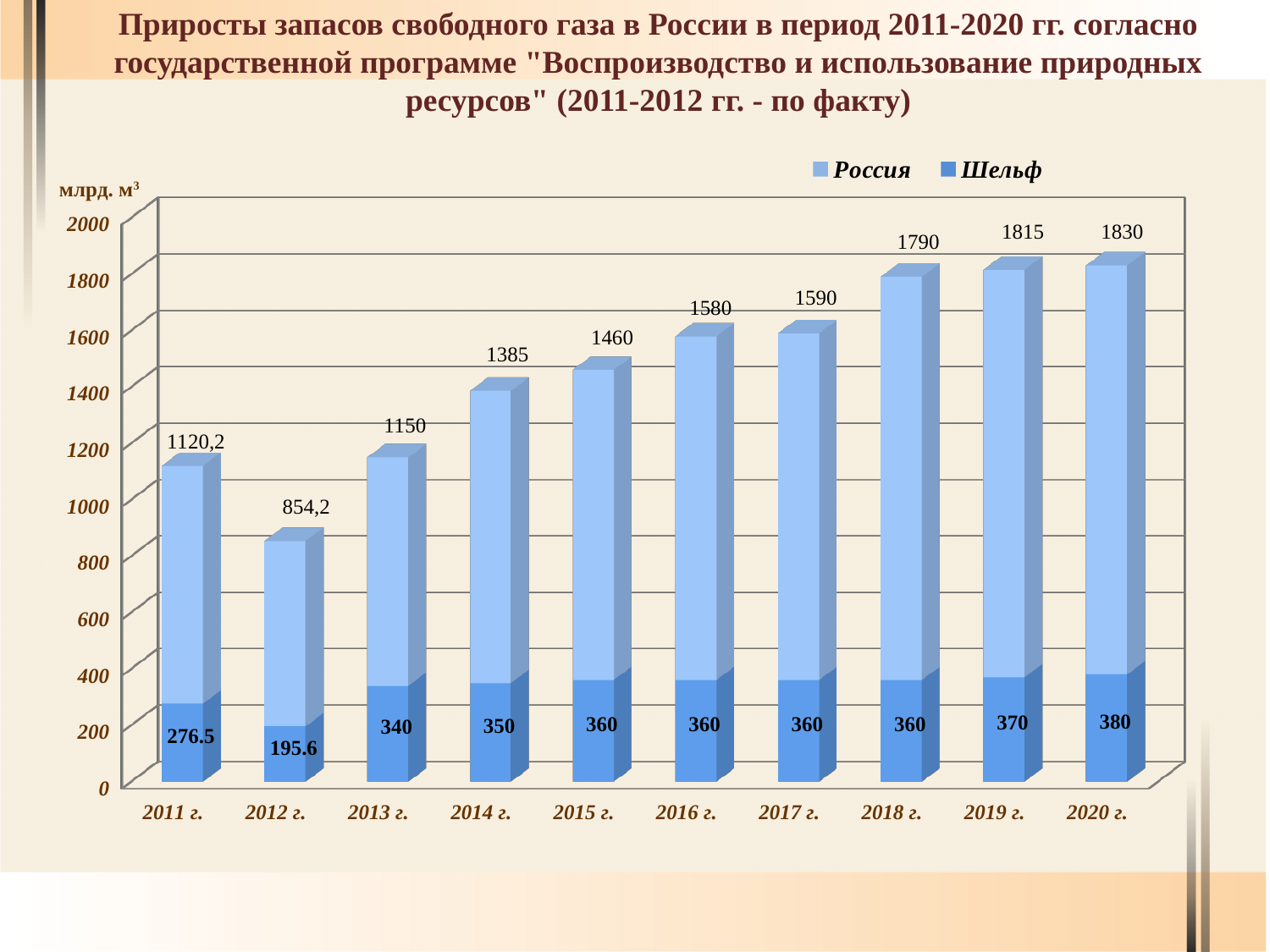
What is the value for Россия in 2016 г.? 1580 What is the difference between the Шельф values for 2013 г. and 2012 г.? 144.4 How many years are shown on the x axis? 10 In which year is the value for Шельф the lowest? 2012 г. What is the value for Шельф in 2020 г.? 380 What kind of chart is shown on the slide? bar chart Which is larger: the Россия value for 2013 г. or for 2012 г.? 2013 г. How many series does the legend list? 2 In which year is the value for Россия the highest? 2020 г. What is the difference between the Россия values for 2020 г. and 2019 г.? 15 What is the value for Шельф in 2012 г.? 195.6 What is the value for Россия in 2011 г.? 1120,2